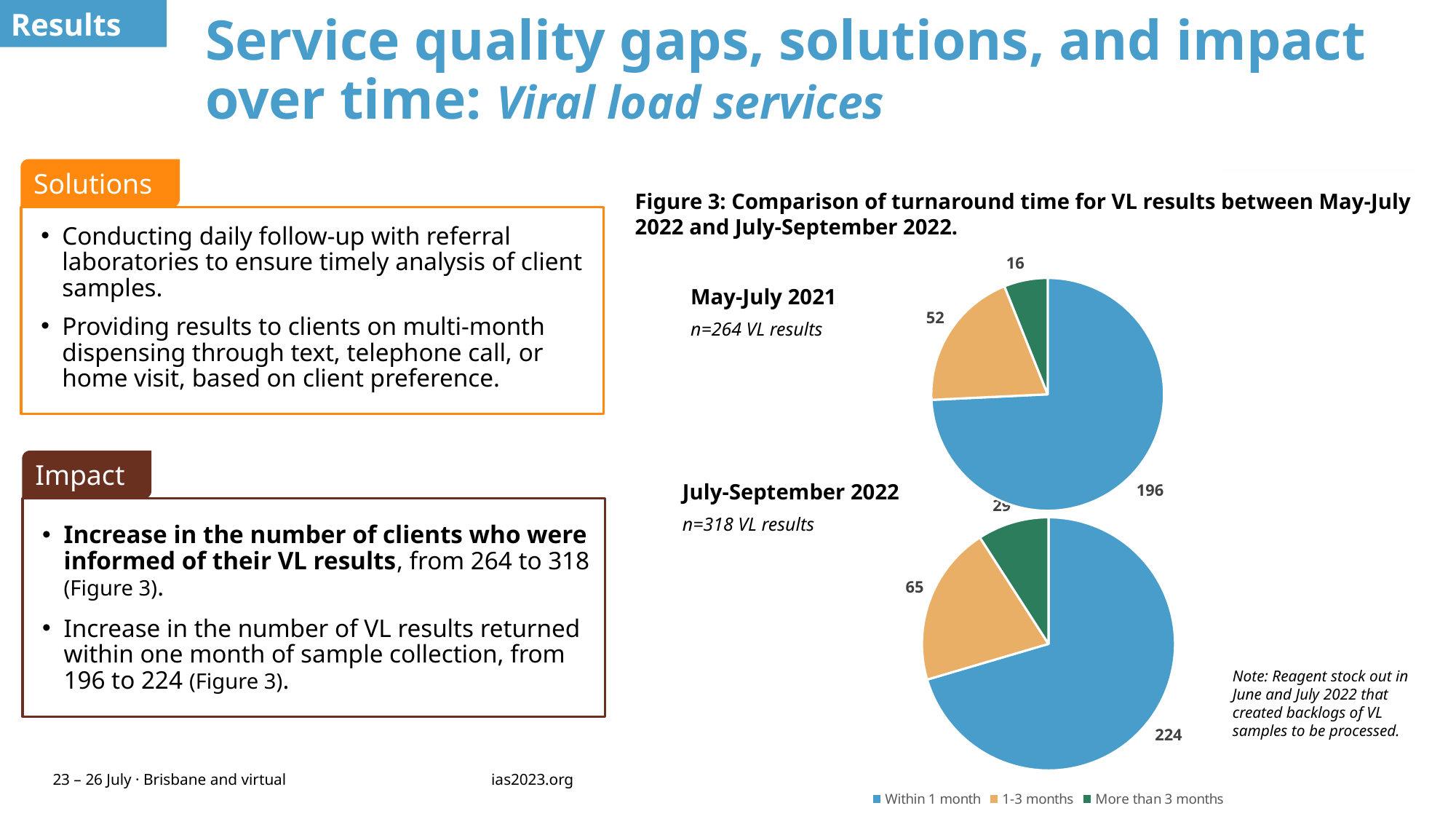
In the May-July 2021 pie chart, how many VL results were returned within 1 month? 196 In the July-September 2022 pie chart, how many VL results were returned within 1 month? 224 Which is larger: the 1-3 months value in the May-July 2021 chart or in the July-September 2022 chart? July-September 2022 What is the total number of VL results shown in the July-September 2022 pie chart? 318 What type of chart is used in Figure 3? Pie chart In the May-July 2021 pie chart, which category has the largest slice? Within 1 month In the July-September 2022 pie chart, how many VL results were returned in 1-3 months? 65 How many categories does the legend of Figure 3 list? 3 In the July-September 2022 pie chart, which category has the smallest slice? More than 3 months In the May-July 2021 pie chart, how many VL results were returned in 1-3 months? 52 In the May-July 2021 pie chart, how many VL results took more than 3 months? 16 What is the difference between the number of results returned within 1 month in July-September 2022 and in May-July 2021? 28